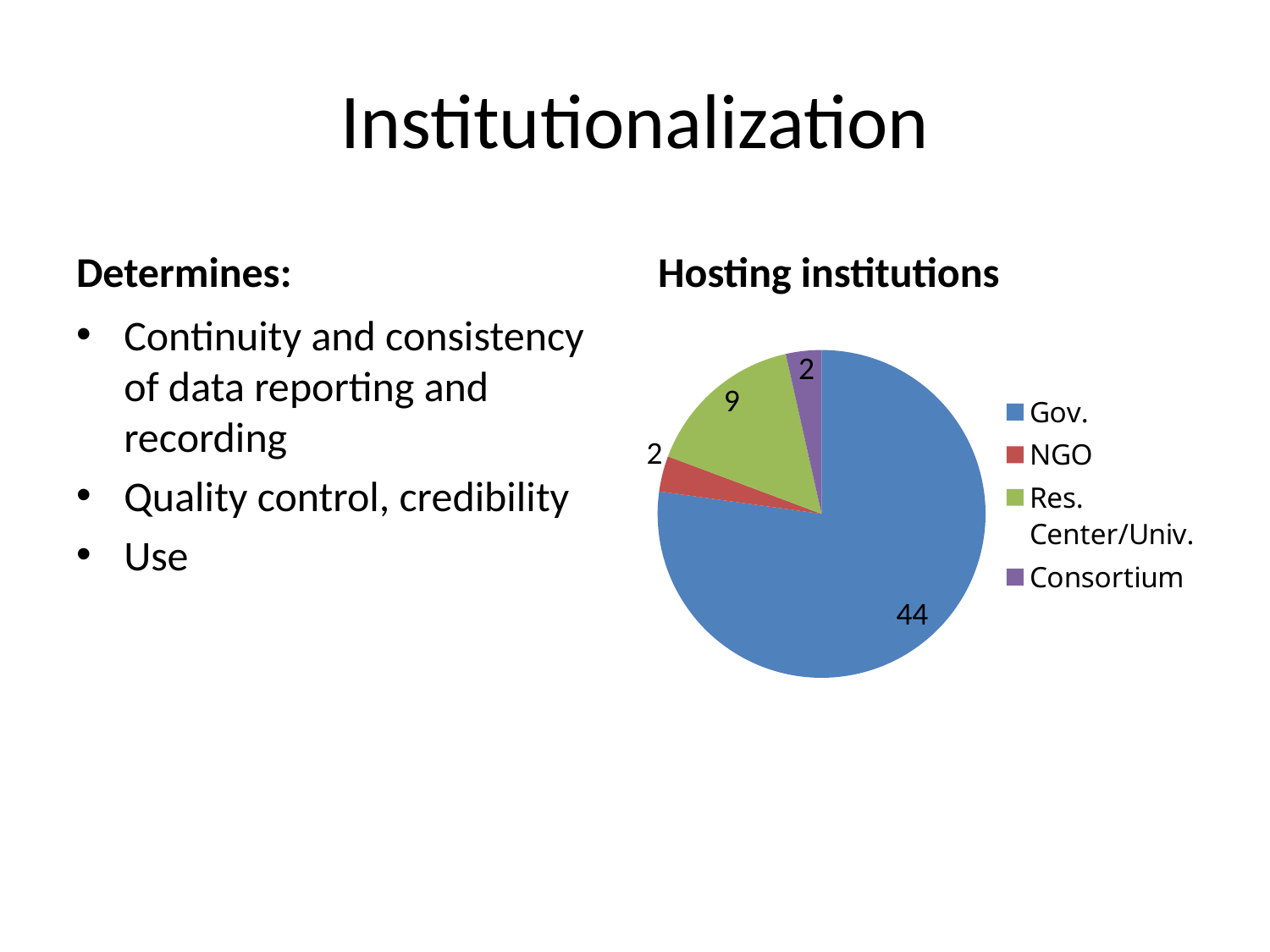
What is the value for NGO in the Hosting institutions pie chart? 2 Which category has the largest slice in the Hosting institutions pie chart? Gov. How many categories does the legend of the Hosting institutions pie chart list? 4 What is the total of all slices in the Hosting institutions pie chart? 57 What is the value for Consortium in the Hosting institutions pie chart? 2 What colour is the Gov. slice in the Hosting institutions pie chart? blue What is the value for Gov. in the Hosting institutions pie chart? 44 What is the value for Res. Center/Univ. in the Hosting institutions pie chart? 9 Which is larger in the Hosting institutions pie chart, Res. Center/Univ. or NGO? Res. Center/Univ. What is the title of the pie chart? Hosting institutions What type of chart is shown on the slide? pie chart What is the difference between the values for Gov. and Res. Center/Univ. in the Hosting institutions pie chart? 35